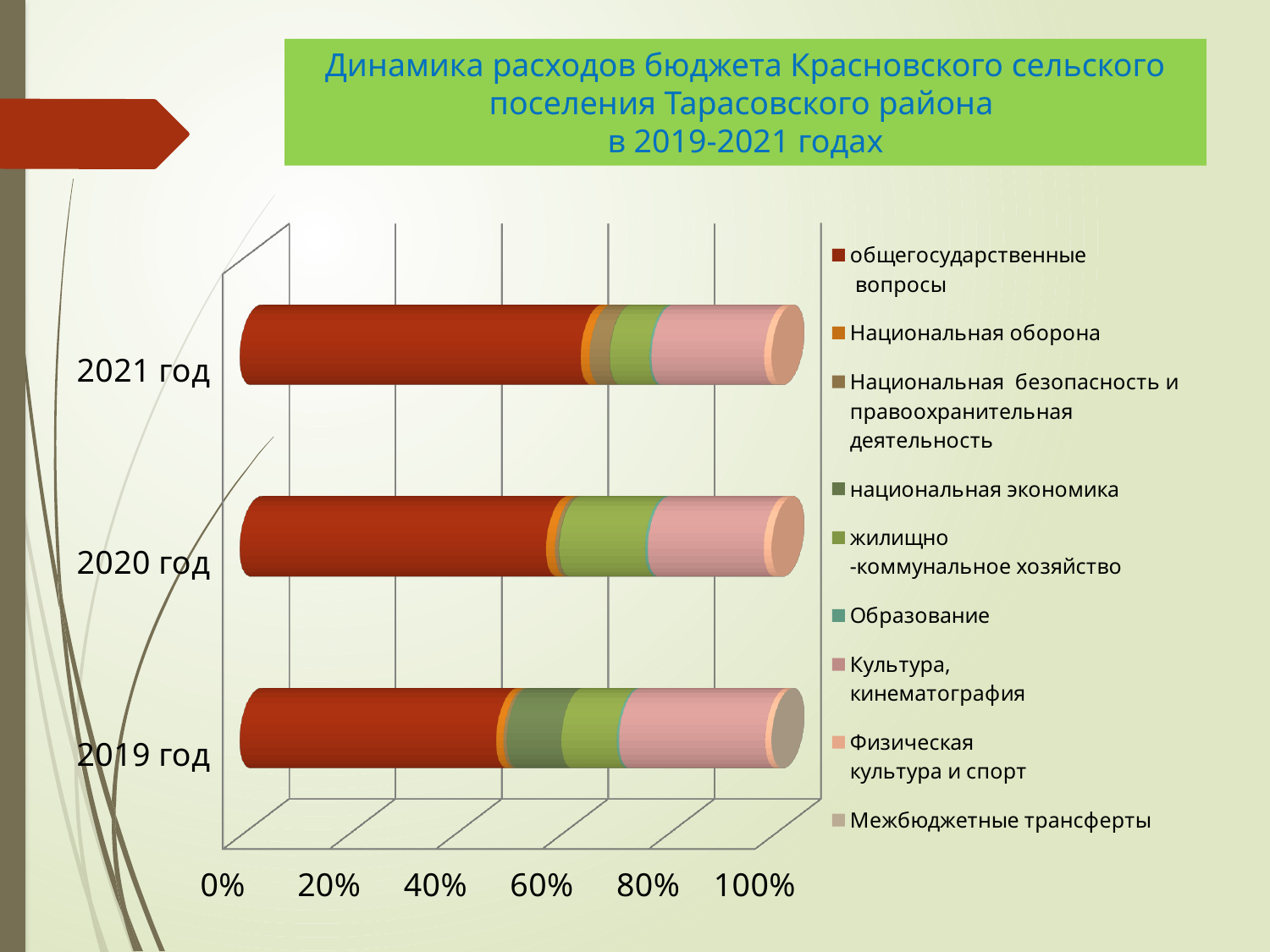
What kind of chart is shown on the slide? Stacked bar chart How many series does the legend list? 9 Is the share of общегосударственные вопросы in 2019 год greater or less than 60%? less Does the share of общегосударственные вопросы rise or fall from 2019 год to 2021 год? rise What is the title of the chart on the slide? Динамика расходов бюджета Красновского сельского поселения Тарасовского района в 2019-2021 годах How many years (categories) are plotted on the chart? 3 Which year has the larger share of общегосударственные вопросы, 2019 год or 2021 год? 2021 год Is the share of общегосударственные вопросы in 2020 год greater or less than 40%? greater Which year has the larger share of Культура, кинематография, 2019 год or 2021 год? 2019 год In which year is the share of общегосударственные вопросы the smallest? 2019 год Is the share of общегосударственные вопросы in 2021 год greater or less than 40%? greater Which legend entry is shown in dark red, the first segment of each bar? общегосударственные вопросы